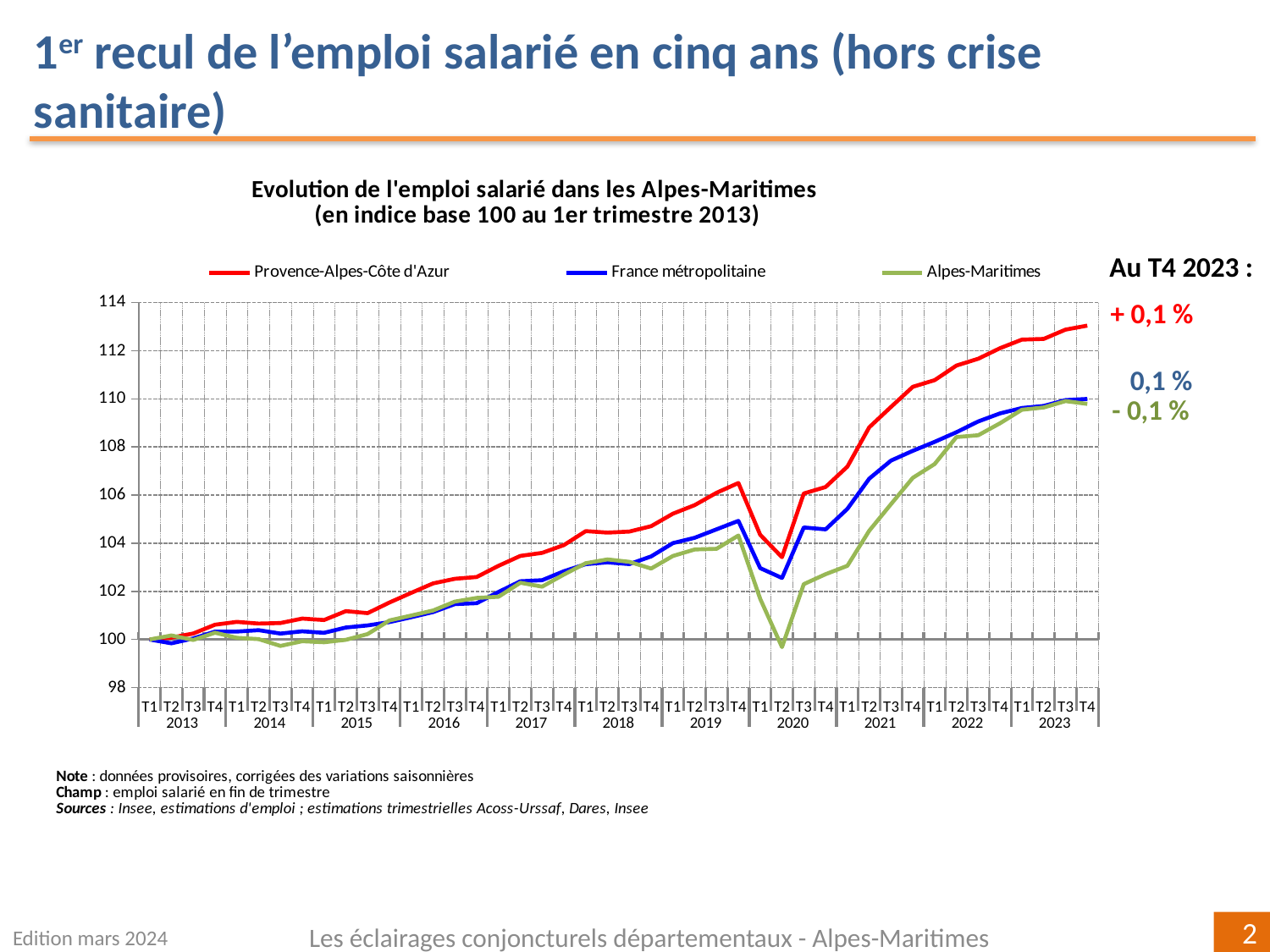
Which series has the lowest value at T2 2020? Alpes-Maritimes Is the value for France métropolitaine at T4 2023 greater or less than 108? greater Which series has the highest value at T4 2023? Provence-Alpes-Côte d'Azur How many series does the legend list? 3 Which series is drawn in red? Provence-Alpes-Côte d'Azur At T4 2023, which is higher: Provence-Alpes-Côte d'Azur or Alpes-Maritimes? Provence-Alpes-Côte d'Azur Is the value for Provence-Alpes-Côte d'Azur at T4 2023 greater or less than 112? greater According to the annotation at T4 2023, what is the change shown for Alpes-Maritimes? - 0,1 % What is the title of the chart? Evolution de l'emploi salarié dans les Alpes-Maritimes (en indice base 100 au 1er trimestre 2013) What kind of chart is shown on the slide? line chart Is the value for Alpes-Maritimes at T2 2020 greater or less than 102? less How many years are labelled along the x axis? 11